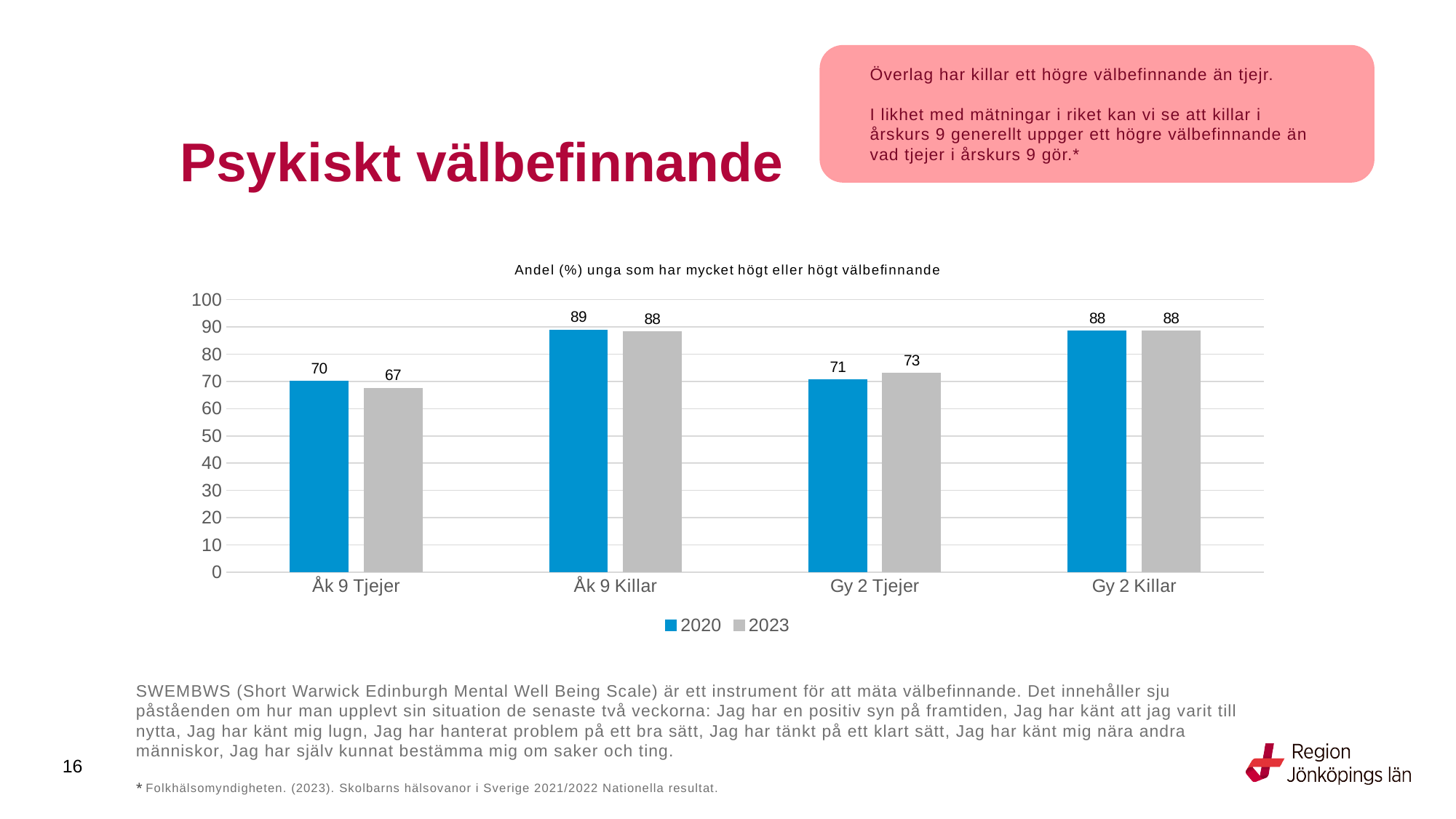
What is the value for Åk 9 Killar in 2023? 88 What is the difference between the 2020 and 2023 values for Åk 9 Tjejer? 3 Which category has the highest value in the 2020 series? Åk 9 Killar What is the title of the chart? Andel (%) unga som har mycket högt eller högt välbefinnande What is the value for Åk 9 Tjejer in 2020? 70 Which is larger for Gy 2 Tjejer: the 2020 value or the 2023 value? 2023 How many categories are shown on the x axis? 4 Is the value for Gy 2 Killar in 2020 greater or less than 80? greater How many series does the legend list? 2 What is the value for Gy 2 Tjejer in 2023? 73 Which category has the lowest value in the 2023 series? Åk 9 Tjejer What kind of chart is shown on the slide? Bar chart